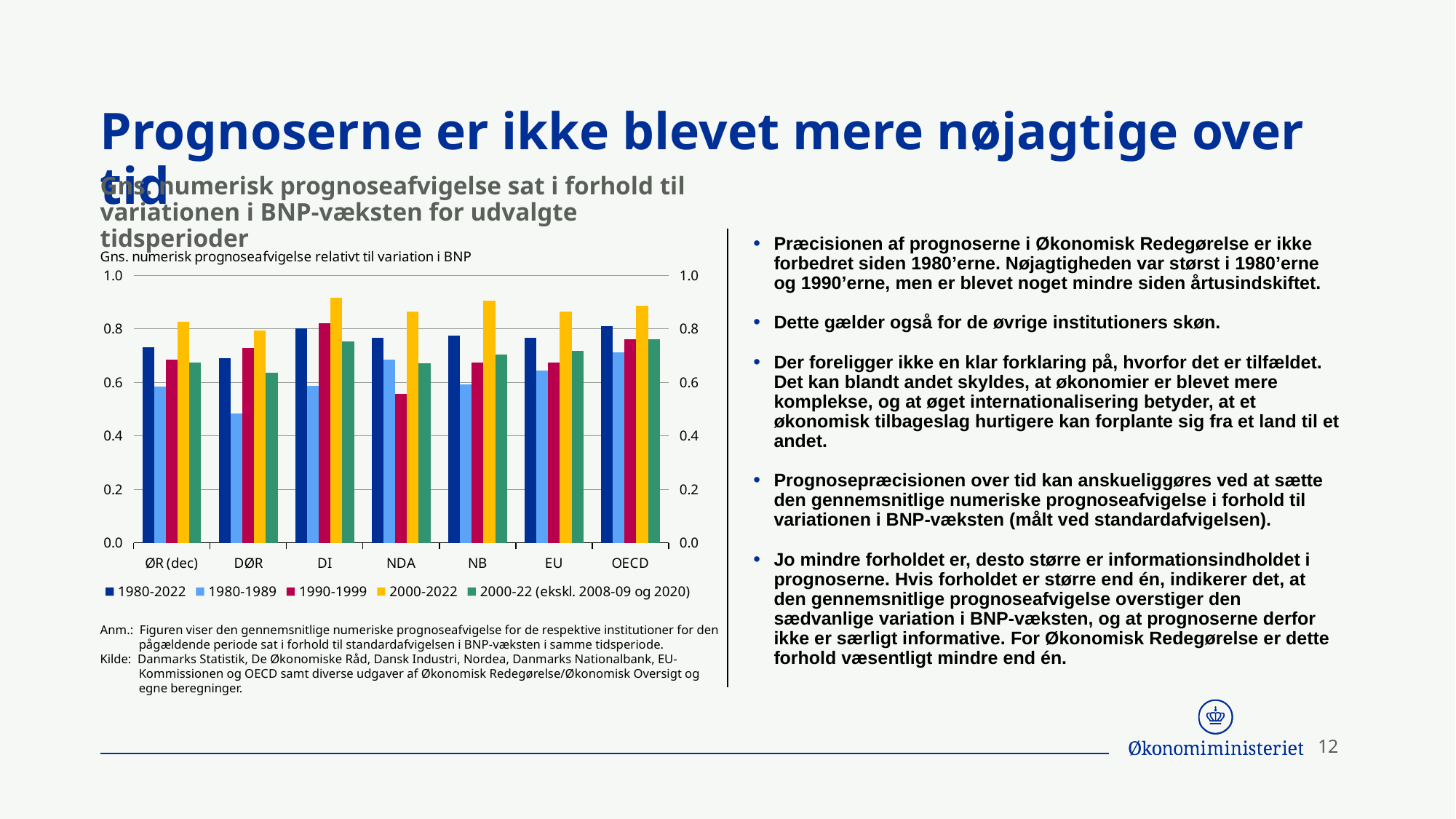
How many institutions (categories) are shown on the x axis of the chart? 7 Which institution has the lowest value in the 1980-1989 series? DØR For NDA, which is larger: the 1980-1989 value or the 1990-1999 value? 1980-1989 For DI, which series has the highest value? 2000-2022 Is the value for DI in the 2000-2022 series greater or less than 0.8? greater How many series does the chart's legend list? 5 Is the value for NB in the 2000-2022 series greater or less than 0.8? greater Is the value for OECD in the 1980-1989 series greater or less than 0.6? greater What is the label shown above the chart's y axis? Gns. numerisk prognoseafvigelse relativt til variation i BNP What kind of chart is shown on the slide? Bar chart In the 1980-2022 series, which is larger: the value for DØR or the value for DI? DI